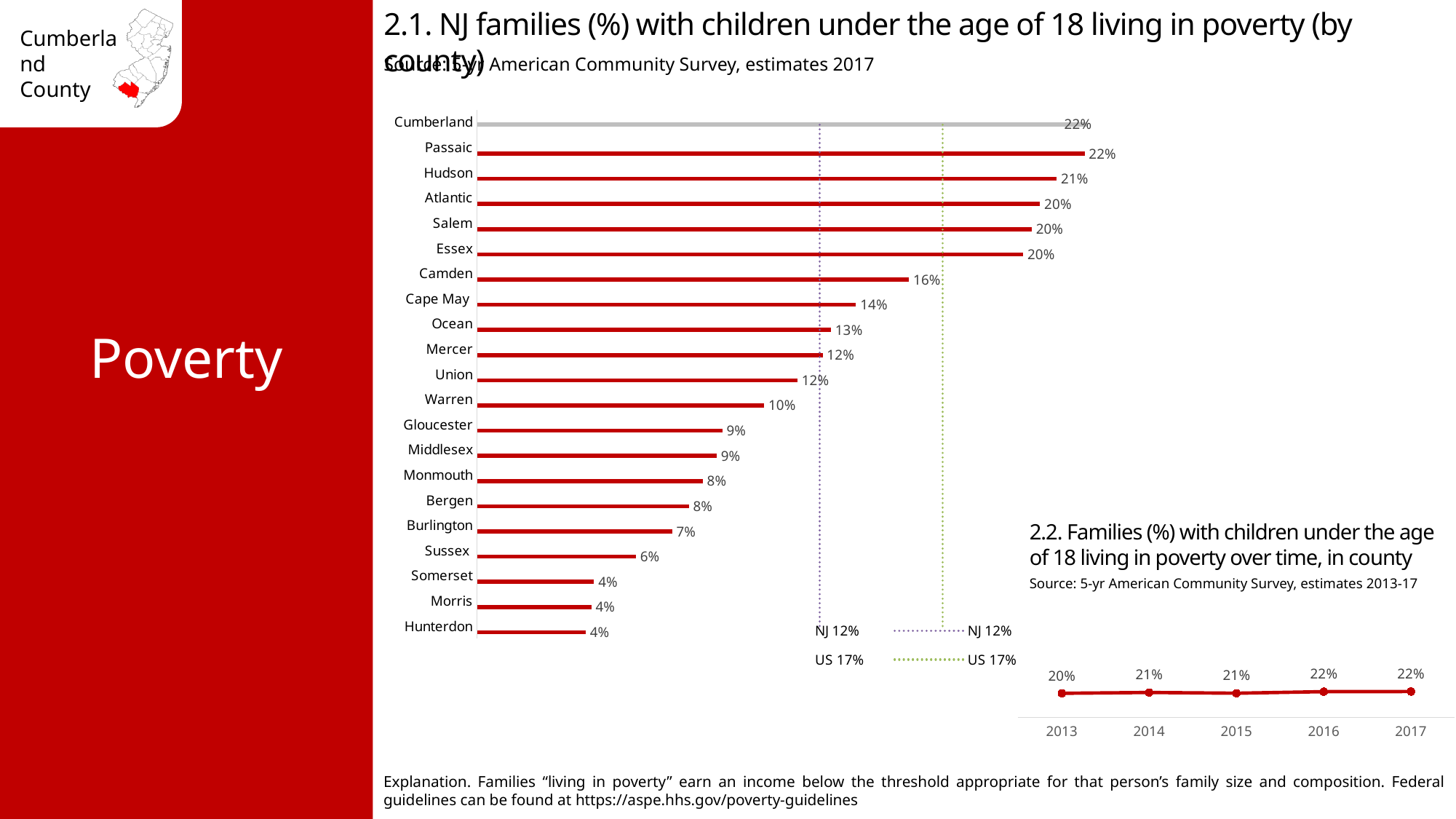
In chart 2.1, what is the value for Sussex? 6% In chart 2.2, what is the value for 2013? 20% In chart 2.2, how many years are plotted? 5 In chart 2.1, which is larger, the value for Hudson or the value for Camden? Hudson In chart 2.1, what is the difference between the values for Camden and Cape May? 2 percentage points In chart 2.1, what percentage of families with children under 18 live in poverty in Cape May? 14% In chart 2.2, do the values rise or fall from 2013 to 2017? Rise In chart 2.1, how many counties are listed? 21 In chart 2.1, what is the value shown for Hudson? 21% In chart 2.1, what is the value for Camden? 16% In chart 2.1, what is the NJ reference value shown by the dotted line? 12% What kind of chart is chart 2.1? Bar chart